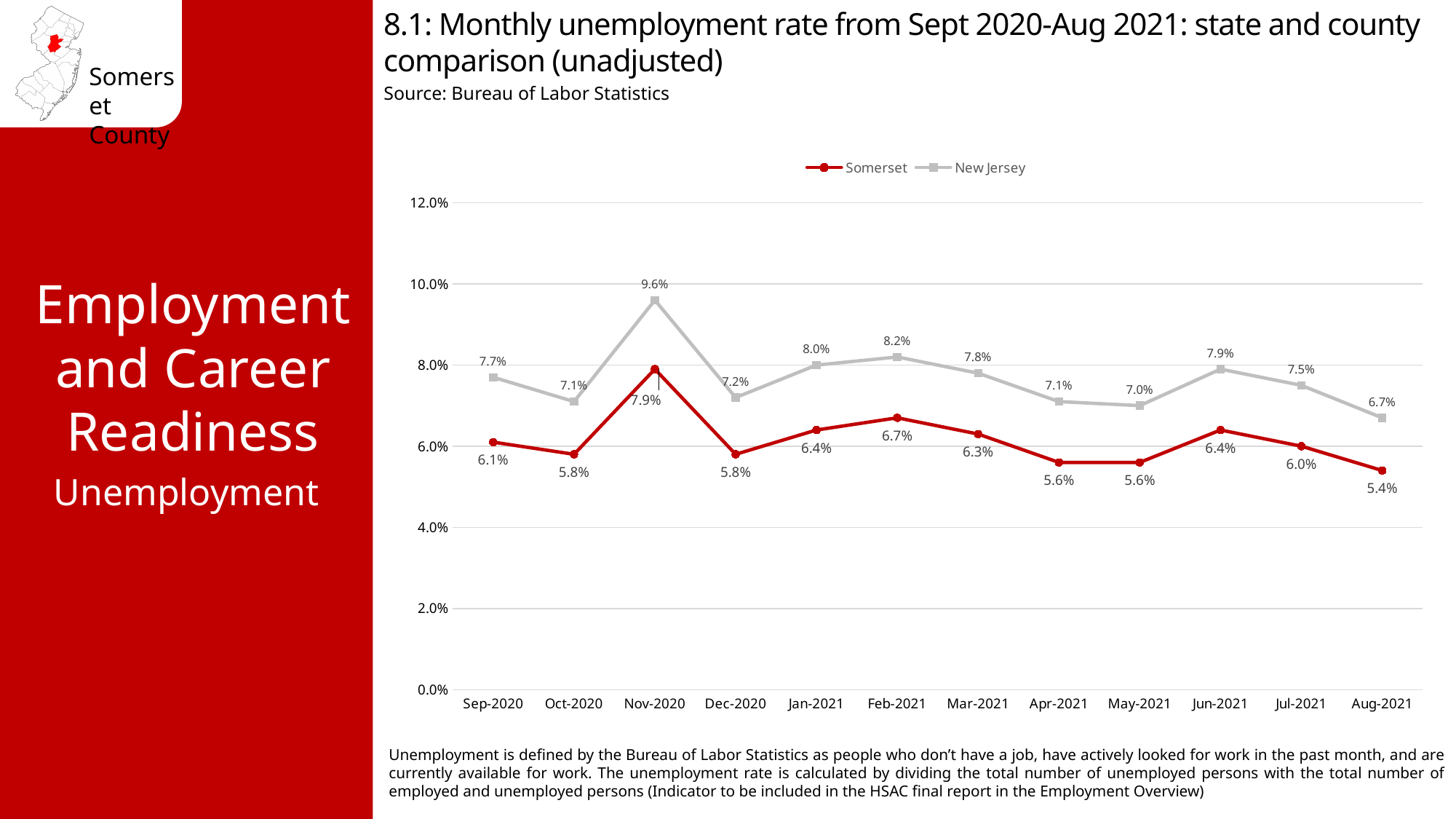
In which month did New Jersey have its highest unemployment rate? Nov-2020 Which had the higher unemployment rate in Jan-2021, Somerset or New Jersey? New Jersey What was the unemployment rate for Somerset in Nov-2020? 7.9% What kind of chart is shown on the slide? Line chart What colour is the line for Somerset? Red What was the unemployment rate for New Jersey in Feb-2021? 8.2% How many series does the legend list? 2 In which month did Somerset have its lowest unemployment rate? Aug-2021 What is the difference between the New Jersey and Somerset unemployment rates in Nov-2020? 1.7% How many months are shown on the x axis? 12 Did the Somerset unemployment rate rise or fall from Jun-2021 to Aug-2021? Fall What was the unemployment rate for Somerset in Aug-2021? 5.4%